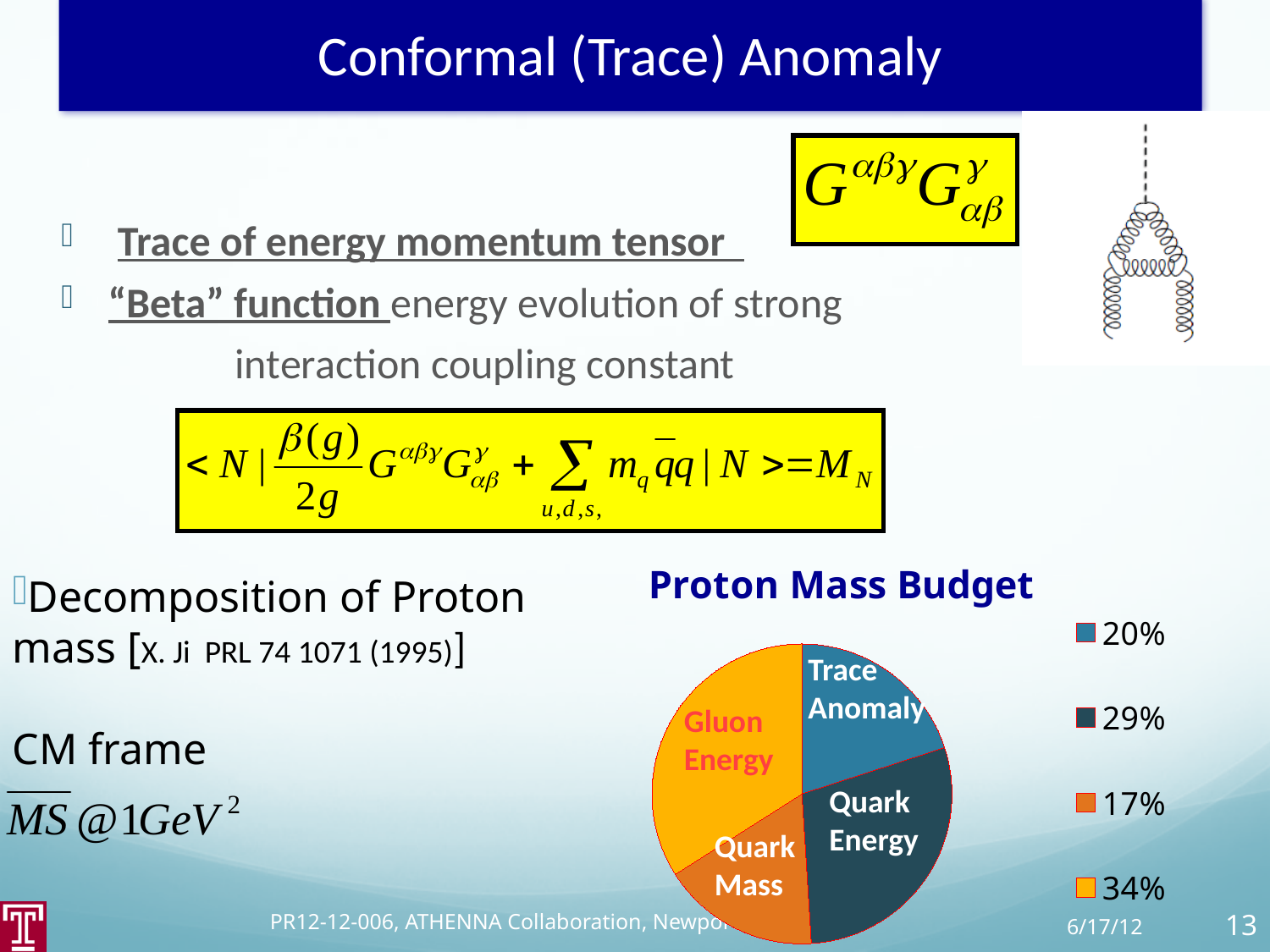
Which slice of the Proton Mass Budget pie chart is the smallest? Quark Mass How many slices does the Proton Mass Budget pie chart have? 4 Which slice of the Proton Mass Budget pie chart is the largest? Gluon Energy In the Proton Mass Budget chart, what share of the proton mass is attributed to Gluon Energy? 34% In the Proton Mass Budget chart, which is larger, the Quark Energy share or the Trace Anomaly share? Quark Energy In the Proton Mass Budget chart, what share of the proton mass is attributed to Quark Energy? 29% What kind of chart is the Proton Mass Budget chart? pie chart How many entries does the legend of the Proton Mass Budget chart list? 4 In the Proton Mass Budget chart, what is the difference between the Gluon Energy share and the Quark Mass share? 17% In the Proton Mass Budget chart, what share of the proton mass is attributed to Quark Mass? 17% What is the title of the pie chart on the slide? Proton Mass Budget